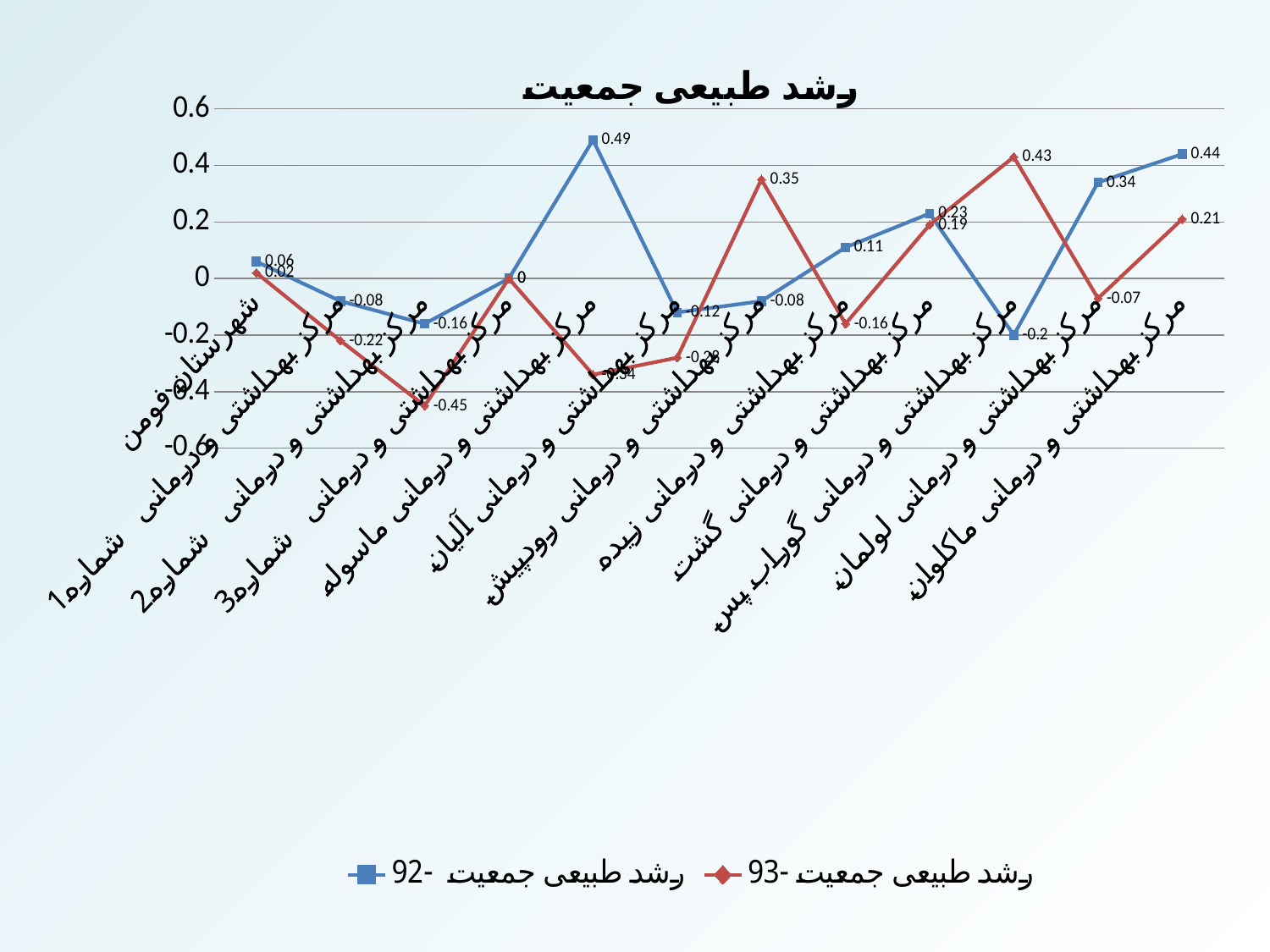
What is the title of the chart? رشد طبیعی جمعیت What is the value of the 'رشد طبیعی جمعیت -93' series for مرکز بهداشتی و درمانی زیده? -0.16 What type of chart is shown on the slide? line chart For مرکز بهداشتی و درمانی لولمان, which series has the larger value, 92 or 93? رشد طبیعی جمعیت -92 Which category has the highest value in the 'رشد طبیعی جمعیت -93' series? مرکز بهداشتی و درمانی گوراب پس What is the difference between the 92 and 93 values for مرکز بهداشتی و درمانی ماکلوان? 0.23 What is the value of the 'رشد طبیعی جمعیت -93' series for مرکز بهداشتی و درمانی گوراب پس? 0.43 What is the value of the 'رشد طبیعی جمعیت -92' series for مرکز بهداشتی و درمانی ماسوله? 0.49 How many series does the legend list? 2 How many categories are plotted along the x axis? 12 Which category has the lowest value in the 'رشد طبیعی جمعیت -93' series? مرکز بهداشتی و درمانی شماره 2 Which category has the highest value in the 'رشد طبیعی جمعیت -92' series? مرکز بهداشتی و درمانی ماسوله